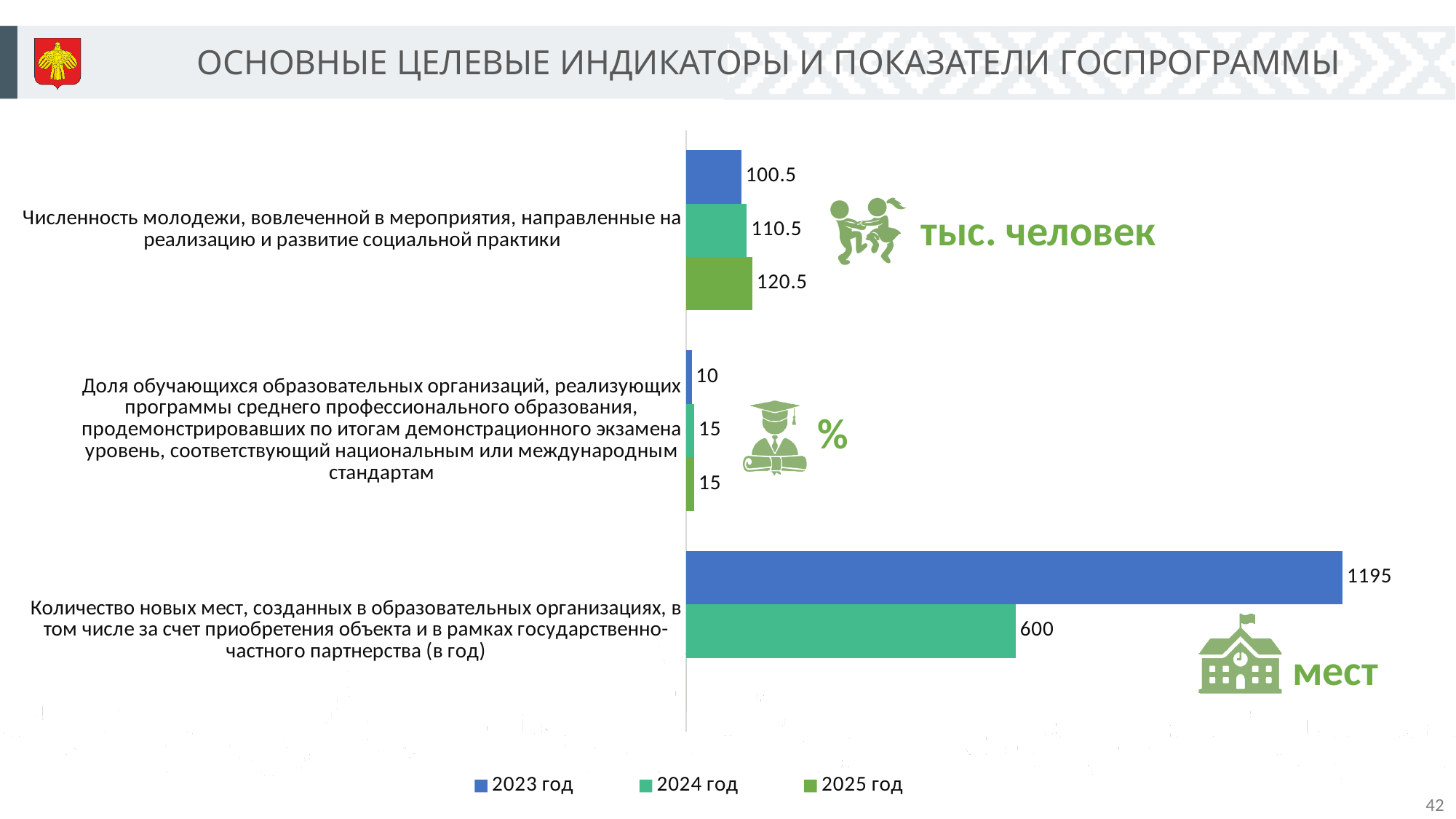
Which legend entry is shown in blue? 2023 год Which series has the highest value for 'Количество новых мест, созданных в образовательных организациях...'? 2023 год Which is larger for 'Численность молодежи, вовлеченной в мероприятия...': the 2024 год value or the 2025 год value? 2025 год What is the value for 2024 год for the category 'Количество новых мест, созданных в образовательных организациях...'? 600 How many categories are shown on the chart? 3 What kind of chart is shown on the slide? bar chart What is the difference between the 2023 год and 2024 год values for 'Количество новых мест, созданных в образовательных организациях...'? 595 What is the value for 2025 год for the category 'Численность молодежи, вовлеченной в мероприятия, направленные на реализацию и развитие социальной практики'? 120.5 How many series does the legend list? 3 What is the value for 2023 год for the category 'Численность молодежи, вовлеченной в мероприятия, направленные на реализацию и развитие социальной практики'? 100.5 What is the value for 2023 год for the category 'Доля обучающихся образовательных организаций, реализующих программы среднего профессионального образования...'? 10 What is the difference between the 2025 год and 2023 год values for 'Численность молодежи, вовлеченной в мероприятия...'? 20